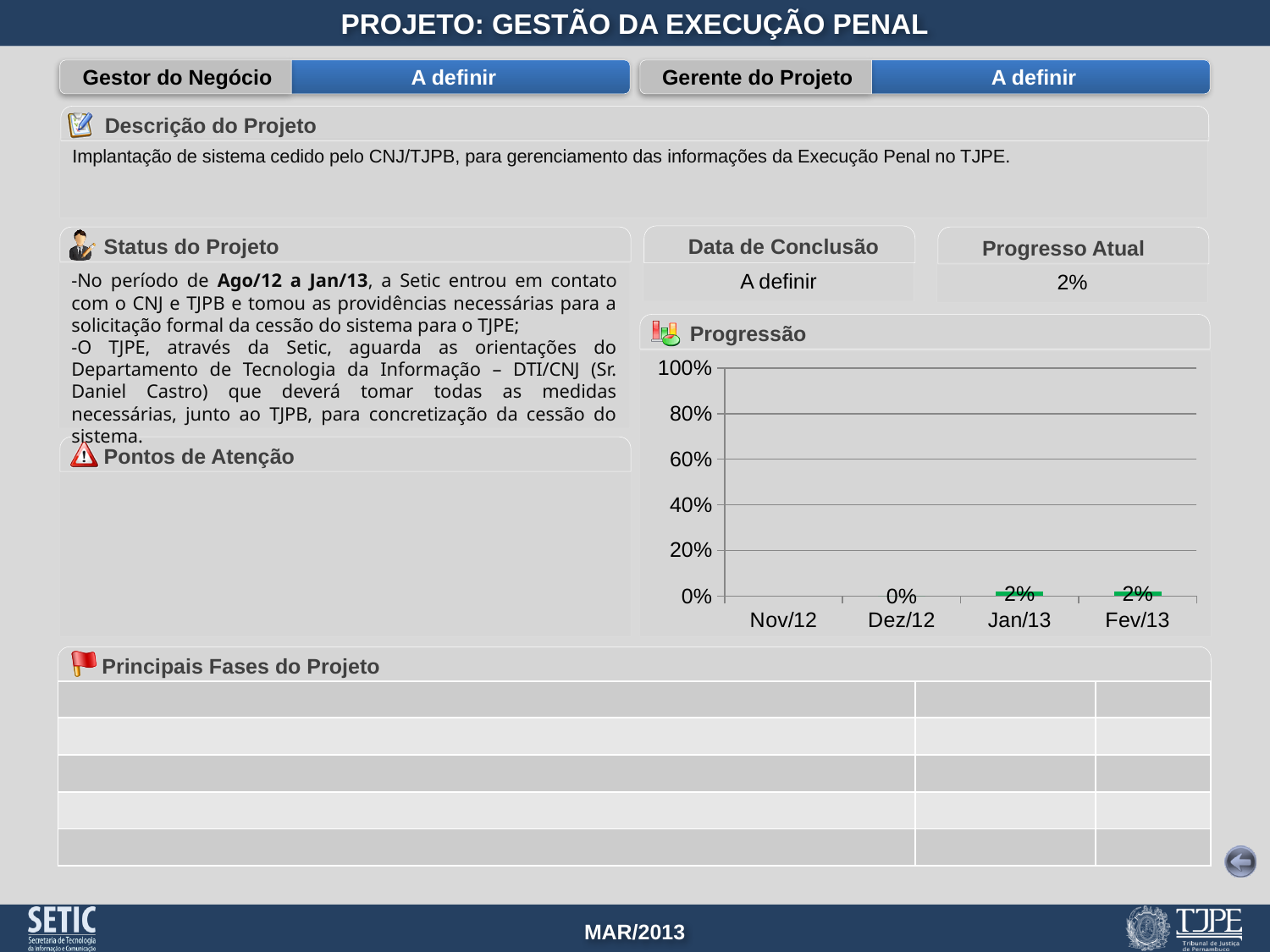
What is the difference between the values for Jan/13 and Dez/12 in the Progressão chart? 2% How many categories are shown on the x axis of the Progressão chart? 4 What is the value shown for Dez/12 in the Progressão chart? 0% Which is larger in the Progressão chart, the value for Jan/13 or the value for Dez/12? Jan/13 What is the value shown for Jan/13 in the Progressão chart? 2% Do the values in the Progressão chart rise or fall from Dez/12 to Jan/13? rise What is the title of the chart on the slide? Progressão What is the value shown for Fev/13 in the Progressão chart? 2% What kind of chart is shown under "Progressão"? bar chart Is the value for Fev/13 in the Progressão chart greater or less than 20%? less What is the highest value shown on the y axis of the Progressão chart? 100%